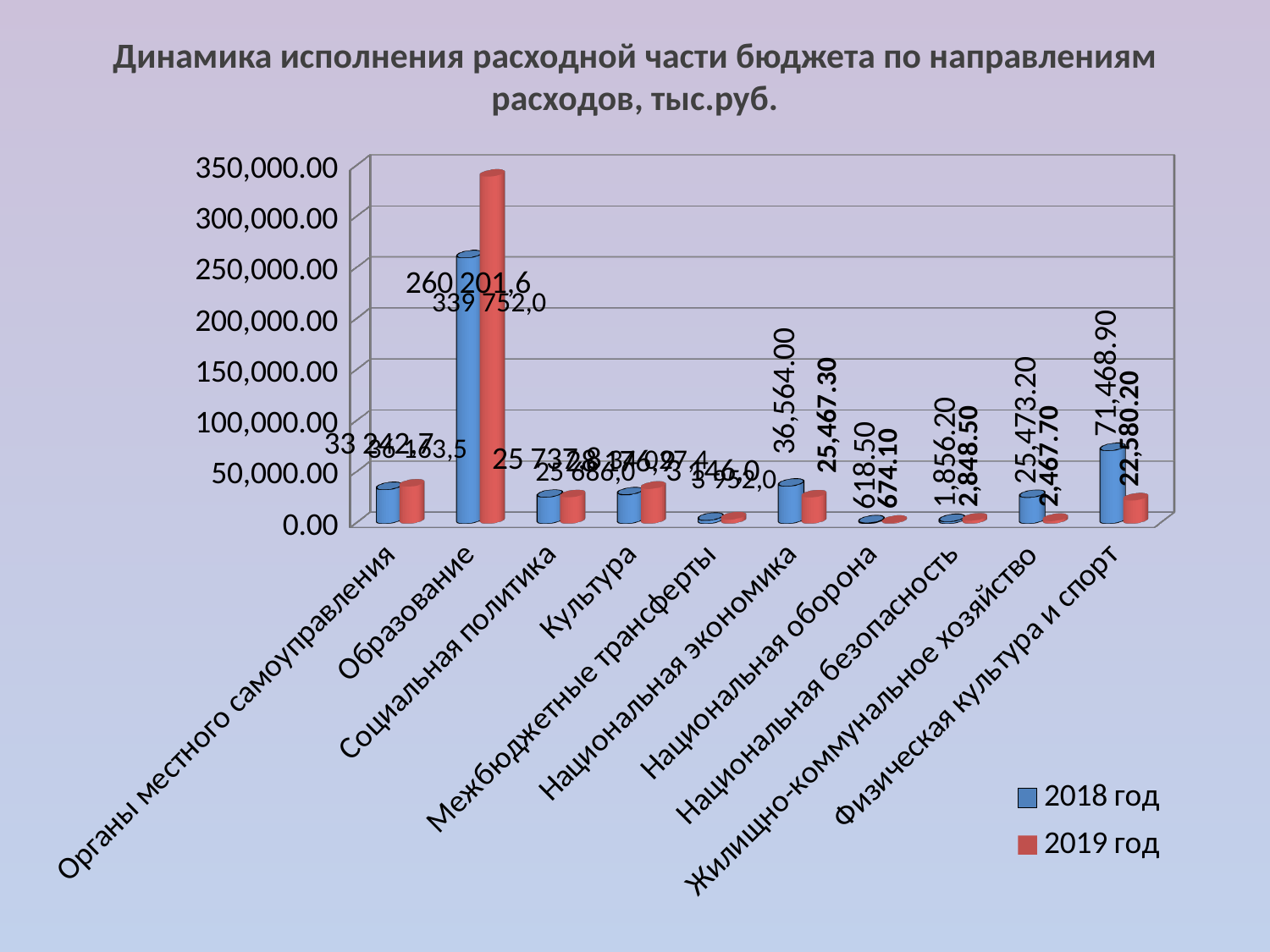
Is the value for Образование in 2019 год greater or less than 300,000.00? greater How many series does the legend list? 2 What are the two entries listed in the legend? 2018 год and 2019 год What is the value for Физическая культура и спорт in 2018 год? 71,468.90 What is the value for Физическая культура и спорт in 2019 год? 22,580.20 What is the value for Национальная оборона in 2019 год? 674.10 What is the difference between the 2019 год and 2018 год values for Национальная безопасность? 992.30 For Жилищно-коммунальное хозяйство, which year has the larger value, 2018 год or 2019 год? 2018 год How many expenditure categories are shown on the x axis? 10 Which category has the highest value for 2019 год? Образование What is the value for Национальная экономика in 2018 год? 36,564.00 What kind of chart is shown on the slide? Bar chart